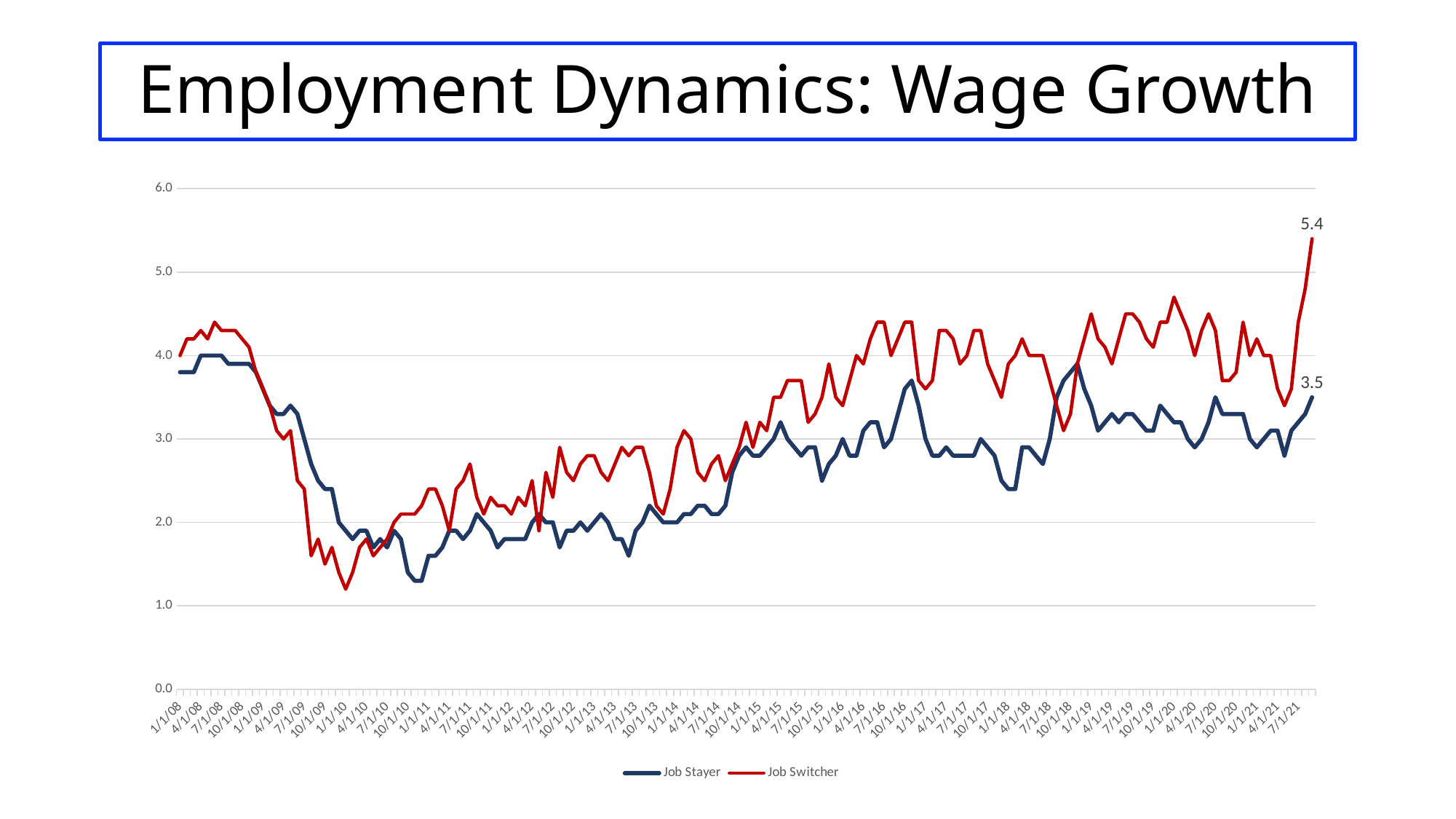
Is the Job Switcher value at 7/1/16 greater or less than 4.0? greater What is the title of the slide? Employment Dynamics: Wage Growth Does the Job Switcher series rise or fall between 1/1/09 and 1/1/10? Fall What is the difference between the final labelled values of the Job Switcher and Job Stayer series? 1.9 Is the Job Stayer value at 1/1/09 greater or less than 3.0? greater What is the final labelled value of the Job Switcher series? 5.4 What colour is the Job Switcher line? Red How many series does the legend list? 2 Is the Job Switcher value at 1/1/10 greater or less than 2.0? less What kind of chart is shown on the slide? Line chart At the end of the series, which is larger: the Job Switcher value or the Job Stayer value? Job Switcher What is the final labelled value of the Job Stayer series? 3.5